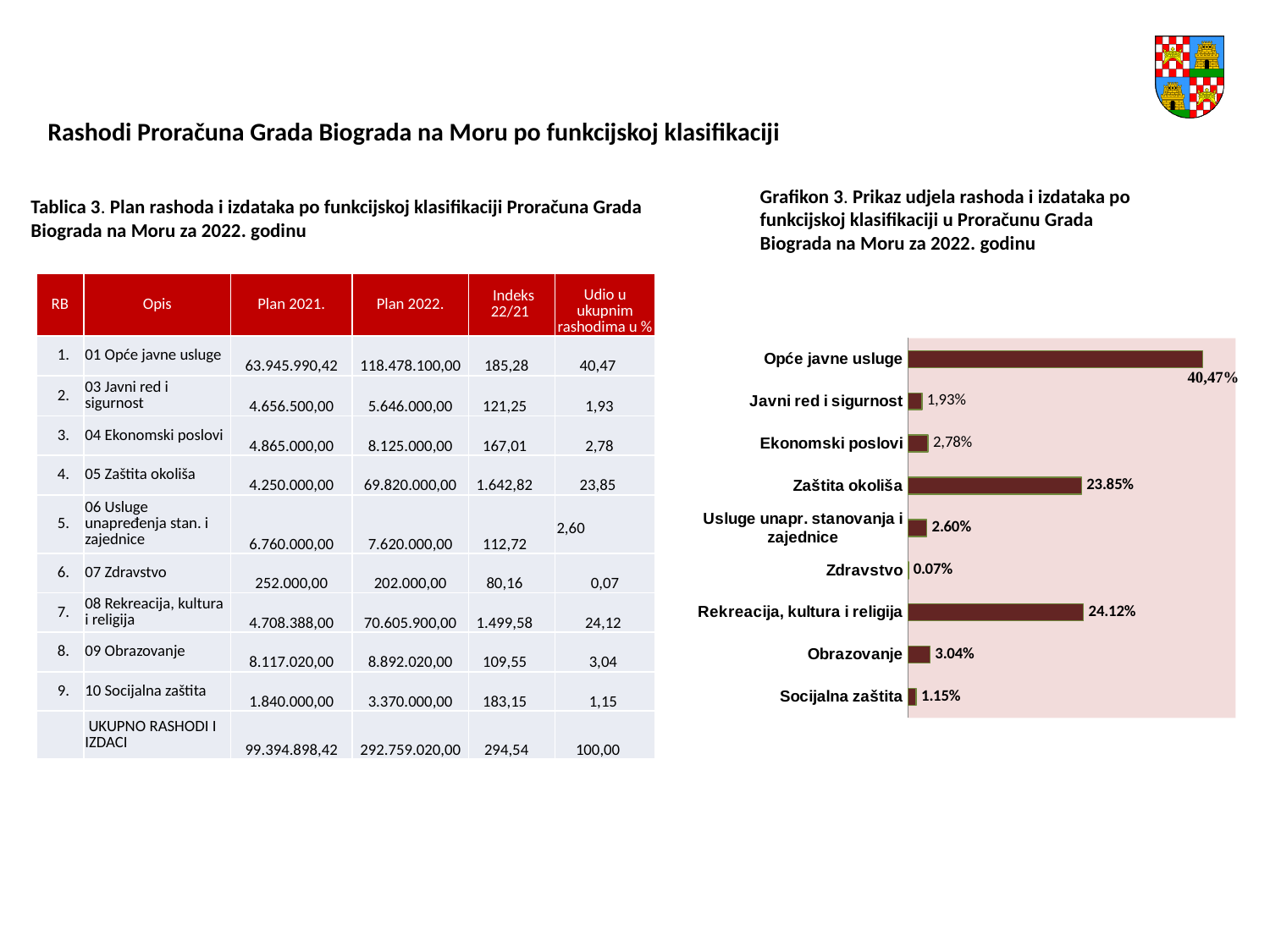
What is the difference between the values for Obrazovanje and Socijalna zaštita? 1.89% What is the value for Zaštita okoliša? 23.85% What is the title of the chart? Grafikon 3. Prikaz udjela rashoda i izdataka po funkcijskoj klasifikaciji u Proračunu Grada Biograda na Moru za 2022. godinu What is the value for Zdravstvo? 0.07% How many categories does the chart show? 9 What is the value for Obrazovanje? 3.04% What is the value for Rekreacija, kultura i religija? 24.12% Which is larger, the value for Ekonomski poslovi or the value for Javni red i sigurnost? Ekonomski poslovi Which category has the lowest value? Zdravstvo What is the value for Opće javne usluge? 40,47% What kind of chart is shown on the slide? bar chart Which category has the highest value? Opće javne usluge